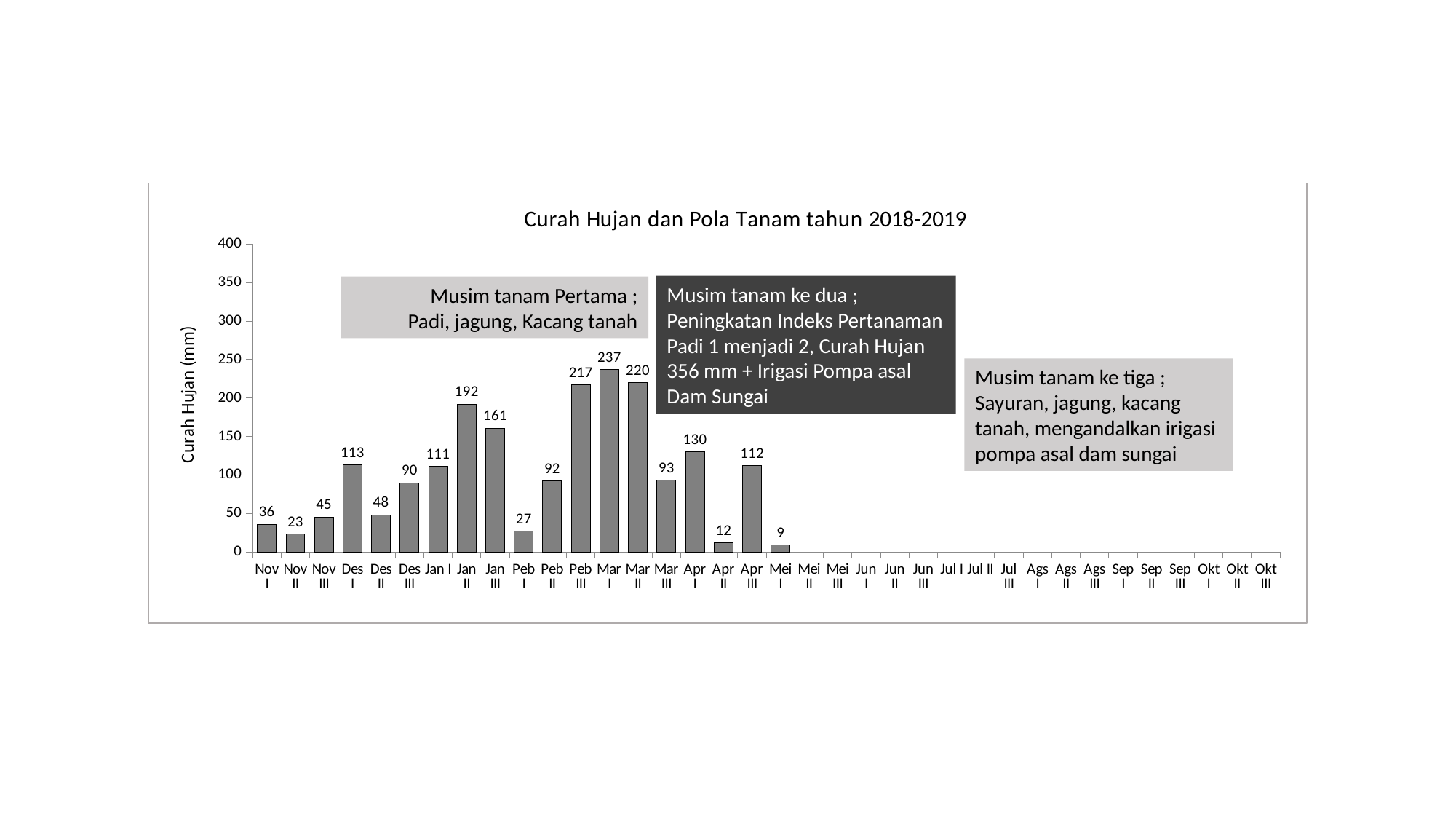
Which has the larger rainfall value, Jan II or Jan III? Jan II Among the periods with a bar shown, which has the lowest rainfall value? Mei I What is the label of the vertical axis? Curah Hujan (mm) Is the value for Peb III greater or less than 200? greater What is the difference between the rainfall values for Mar I and Mar II? 17 Which period has the highest rainfall value? Mar I What is the title of the chart? Curah Hujan dan Pola Tanam tahun 2018-2019 What is the rainfall value for Des III? 90 What is the rainfall value for Mar I? 237 What is the rainfall value for Apr II? 12 What kind of chart is shown on the slide? bar chart How many bars with data labels are plotted on the chart? 19